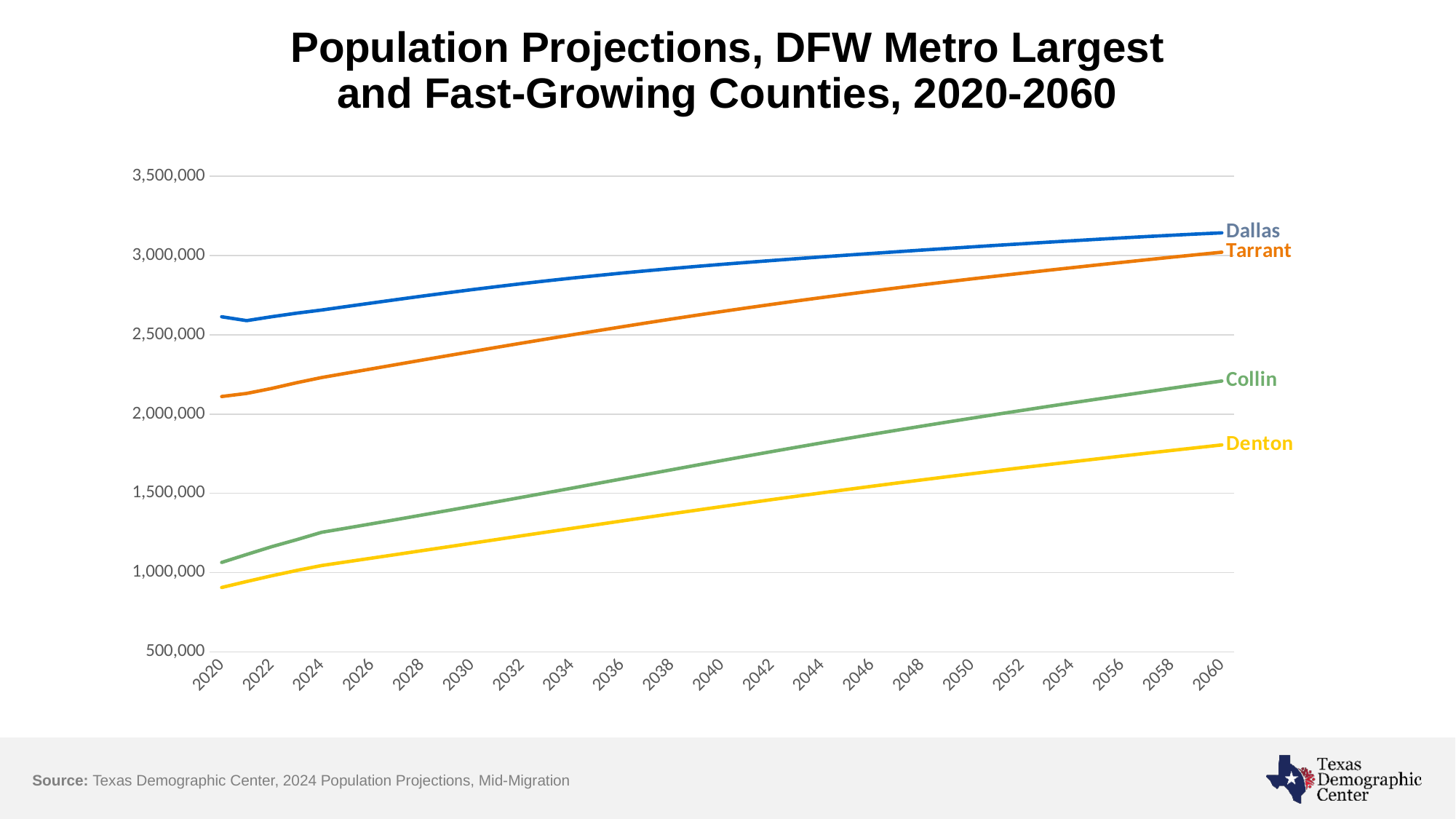
In 2020, which county has the larger projected population, Dallas or Tarrant? Dallas Does the projected population for Collin rise or fall from 2020 to 2060? Rises How many year labels are shown on the x axis? 21 Is the value for Collin in 2060 greater or less than 2,000,000? greater How many series (counties) are plotted on the chart? 4 Which county has the highest projected population in 2060? Dallas What is the title of the chart? Population Projections, DFW Metro Largest and Fast-Growing Counties, 2020-2060 Is the value for Denton in 2020 greater or less than 1,000,000? less Is the value for Tarrant in 2020 greater or less than 2,000,000? greater Which county has the lowest projected population in 2020? Denton What kind of chart is shown on the slide? Line chart